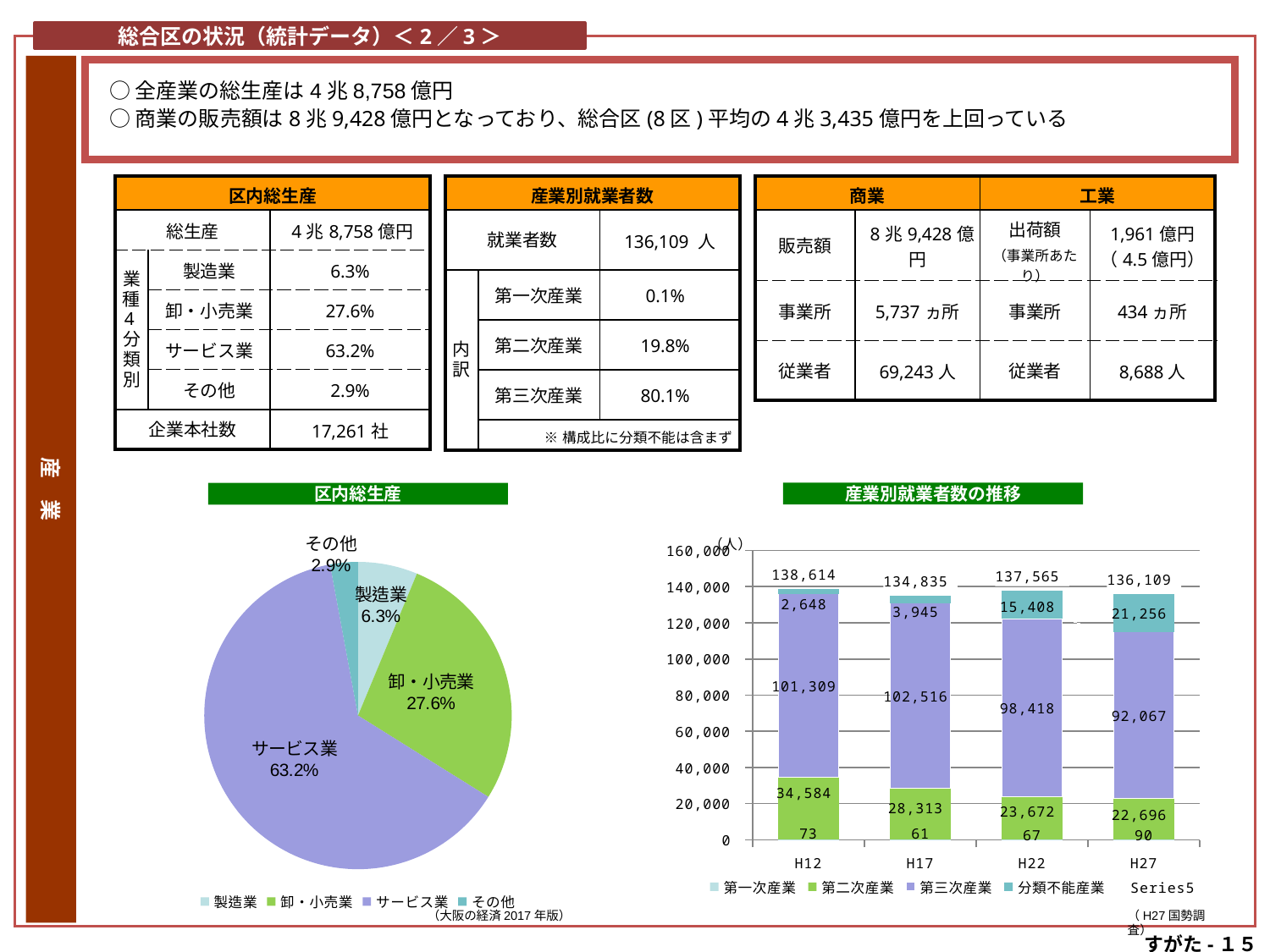
How many entries does the legend of the 産業別就業者数の推移 chart list? 5 In the 産業別就業者数の推移 chart, what is the total for H22? 137,565 In the 区内総生産 pie chart, what share does サービス業 have? 63.2% In the 産業別就業者数の推移 chart, does 第二次産業 rise or fall from H12 to H27? Fall In the 区内総生産 pie chart, which category has the smallest share? その他 In the 区内総生産 pie chart, what is the difference between the shares of 卸・小売業 and 製造業? 21.3% In the 産業別就業者数の推移 chart, which year has the highest total? H12 What kind of chart is the 区内総生産 chart? Pie chart How many slices does the 区内総生産 pie chart have? 4 In the 産業別就業者数の推移 chart, what is the difference in 第二次産業 between H12 and H27? 11,888 In the 産業別就業者数の推移 chart, what is the value of 第三次産業 for H17? 102,516 In the 産業別就業者数の推移 chart, is 分類不能産業 larger in H22 or H27? H27